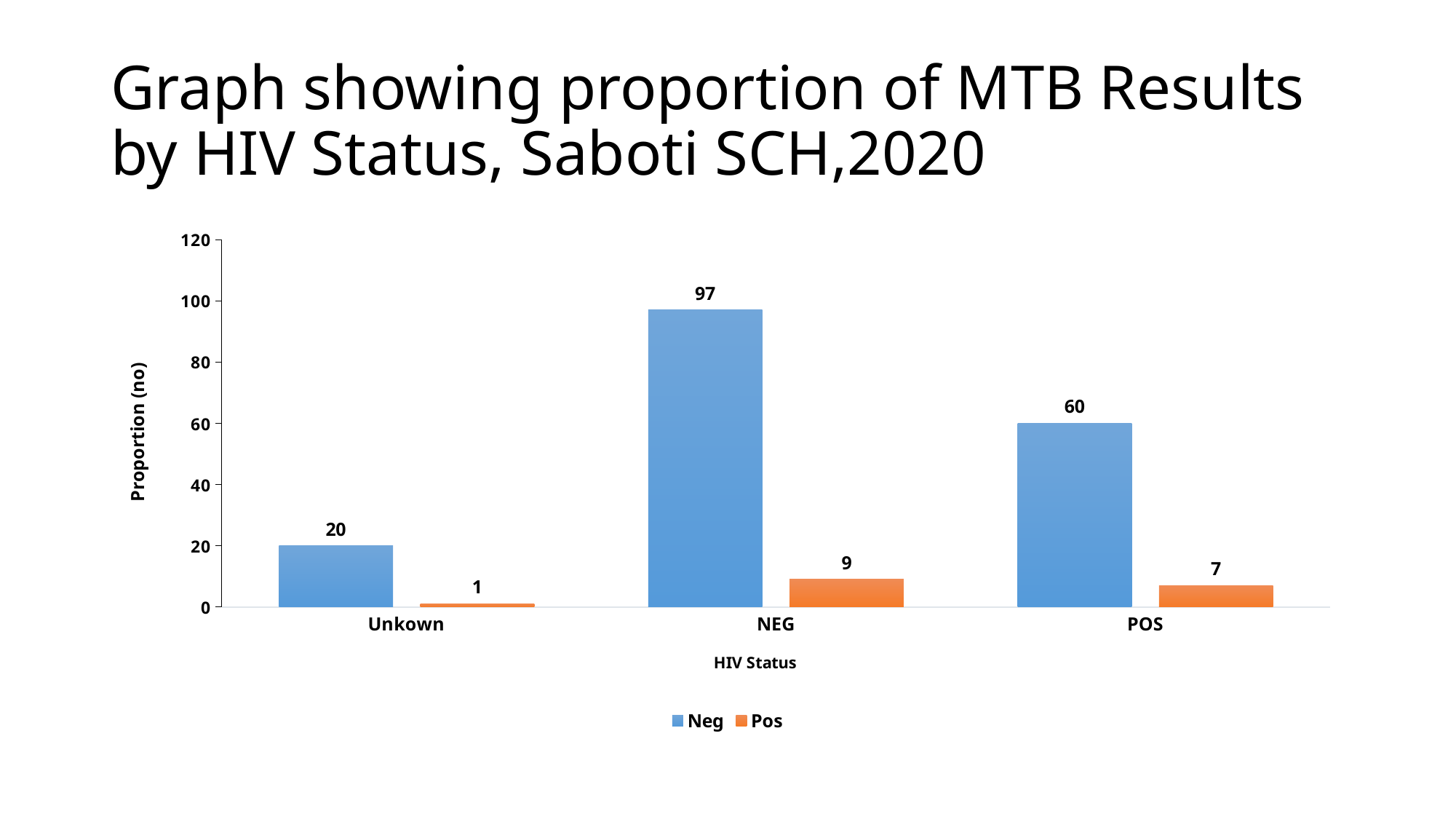
Is the Neg value for POS greater or less than 40? greater Which is larger, the Pos value for NEG or the Pos value for POS? NEG What is the Pos value for the POS HIV status category? 7 How many HIV status categories are shown on the x axis? 3 Which HIV status category has the lowest Pos value? Unkown What is the Pos value for the Unkown category? 1 What is the Neg value for the NEG HIV status category? 97 Which HIV status category has the highest Neg value? NEG What kind of chart is shown on the slide? Bar chart How many series does the legend list? 2 What is the label of the y axis? Proportion (no) What is the difference between the Neg values for NEG and POS? 37